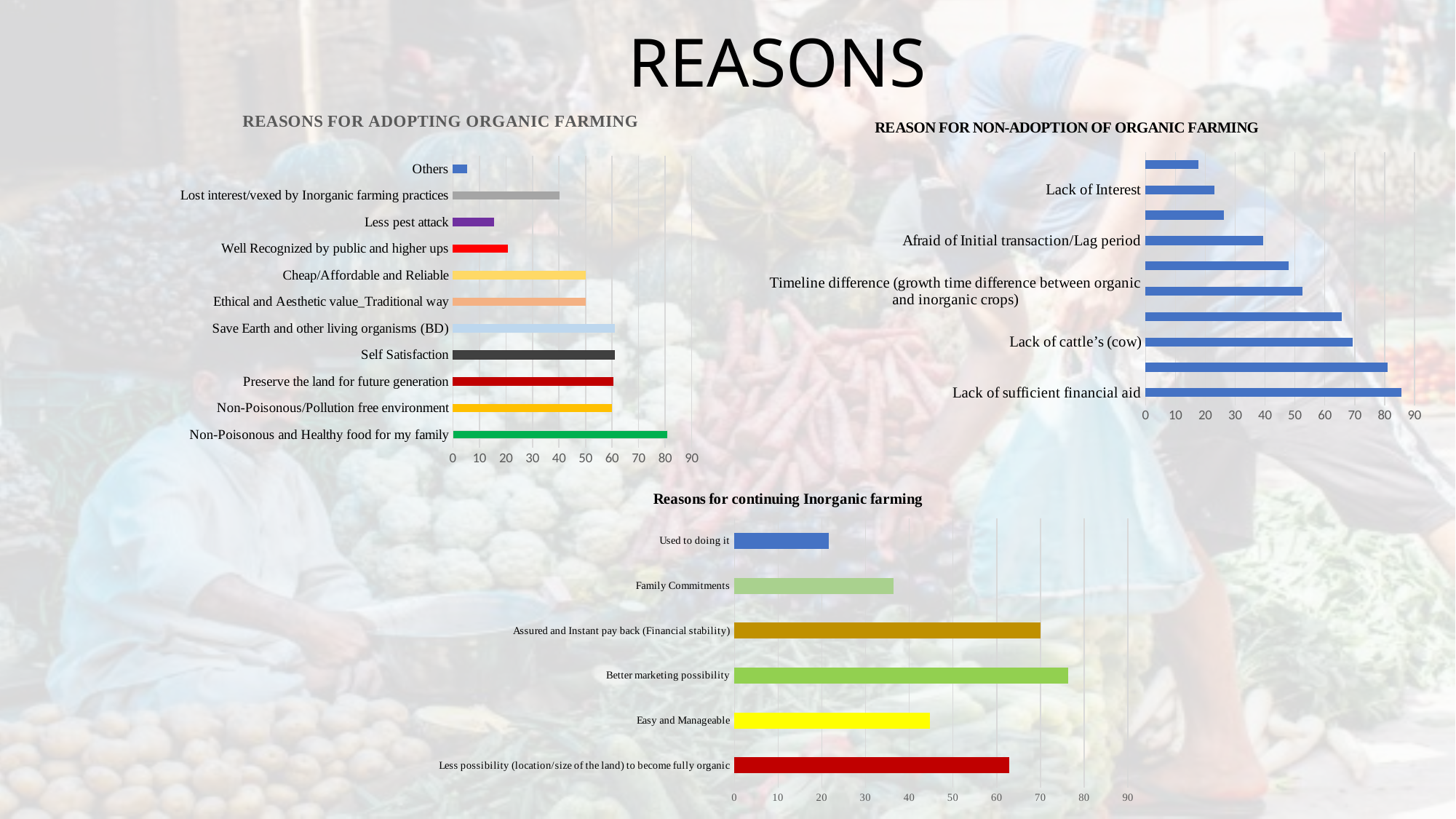
In the 'REASONS FOR ADOPTING ORGANIC FARMING' chart, which category has the highest value? Non-Poisonous and Healthy food for my family In the 'Reasons for continuing Inorganic farming' chart, is the value for 'Easy and Manageable' greater or less than 40? greater In the 'Reasons for continuing Inorganic farming' chart, which category has the highest value? Better marketing possibility In the 'REASON FOR NON-ADOPTION OF ORGANIC FARMING' chart, which labelled category has the highest value? Lack of sufficient financial aid What kind of chart is the 'REASONS FOR ADOPTING ORGANIC FARMING' chart? bar chart In the 'REASON FOR NON-ADOPTION OF ORGANIC FARMING' chart, which is larger: 'Lack of cattle's (cow)' or 'Afraid of Initial transaction/Lag period'? Lack of cattle's (cow) In the 'REASONS FOR ADOPTING ORGANIC FARMING' chart, how many categories are plotted? 11 In the 'REASONS FOR ADOPTING ORGANIC FARMING' chart, which category has the lowest value? Others In the 'REASON FOR NON-ADOPTION OF ORGANIC FARMING' chart, is the value for 'Lack of Interest' greater or less than 30? less In the 'REASONS FOR ADOPTING ORGANIC FARMING' chart, is the value for 'Lost interest/vexed by Inorganic farming practices' greater or less than 30? greater In the 'REASONS FOR ADOPTING ORGANIC FARMING' chart, which is larger: 'Less pest attack' or 'Well Recognized by public and higher ups'? Well Recognized by public and higher ups In the 'Reasons for continuing Inorganic farming' chart, how many categories are plotted? 6